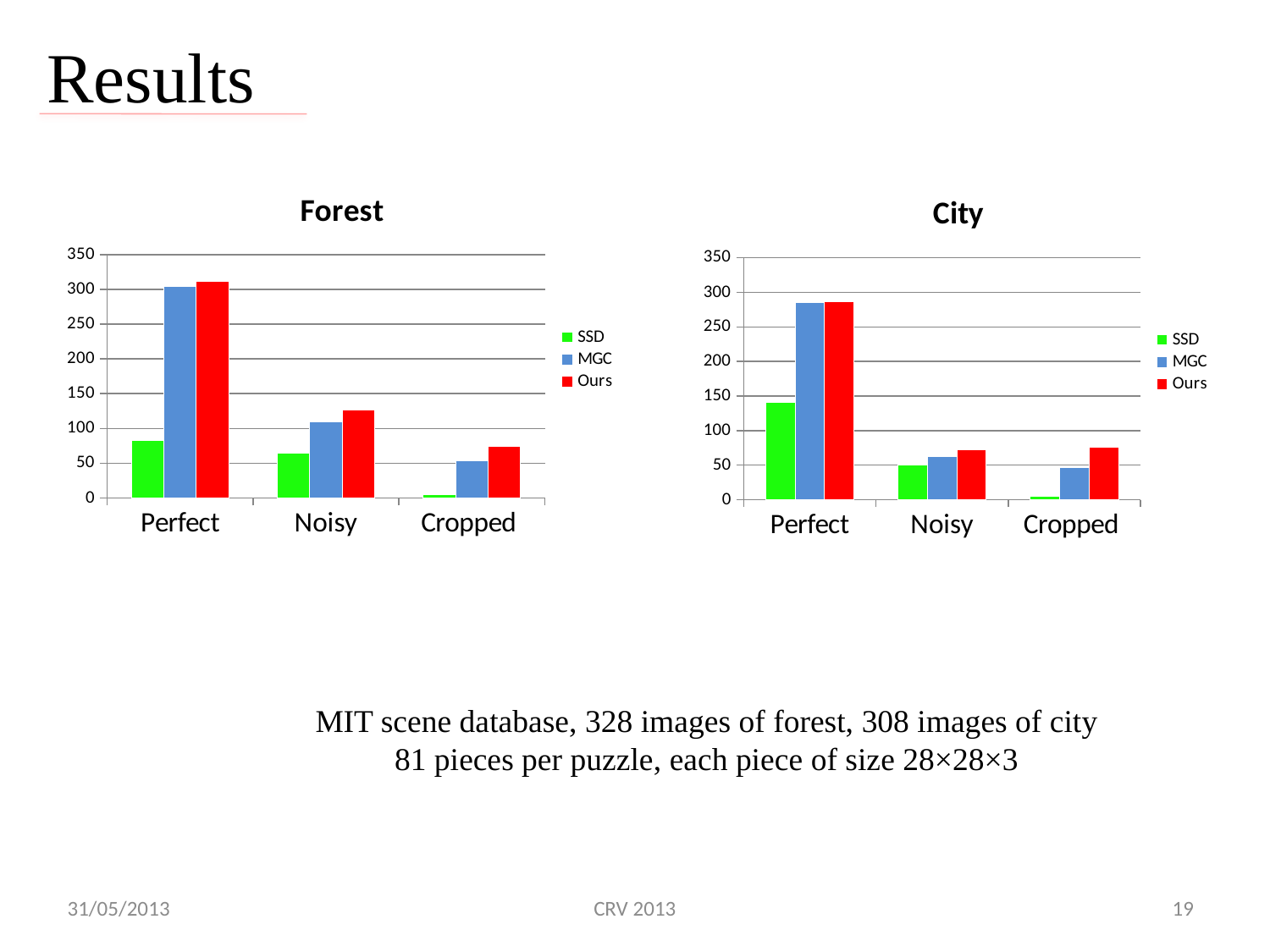
In the Forest chart, which colour represents the Ours series? red What kind of chart is the City chart? bar chart In the City chart, is the value for Ours in the Cropped category greater or less than 50? greater In the Forest chart, is the value for Ours in the Noisy category greater or less than 100? greater In the Forest chart, is the value for SSD in the Perfect category greater or less than 100? less In the Forest chart, in the Noisy category, which is larger: MGC or Ours? Ours In the City chart, in the Cropped category, which is larger: MGC or Ours? Ours In the City chart, which category has the lowest value for the SSD series? Cropped How many series does the legend of the City chart list? 3 In the Forest chart, which category has the highest value for the Ours series? Perfect How many categories are shown on the x axis of the Forest chart? 3